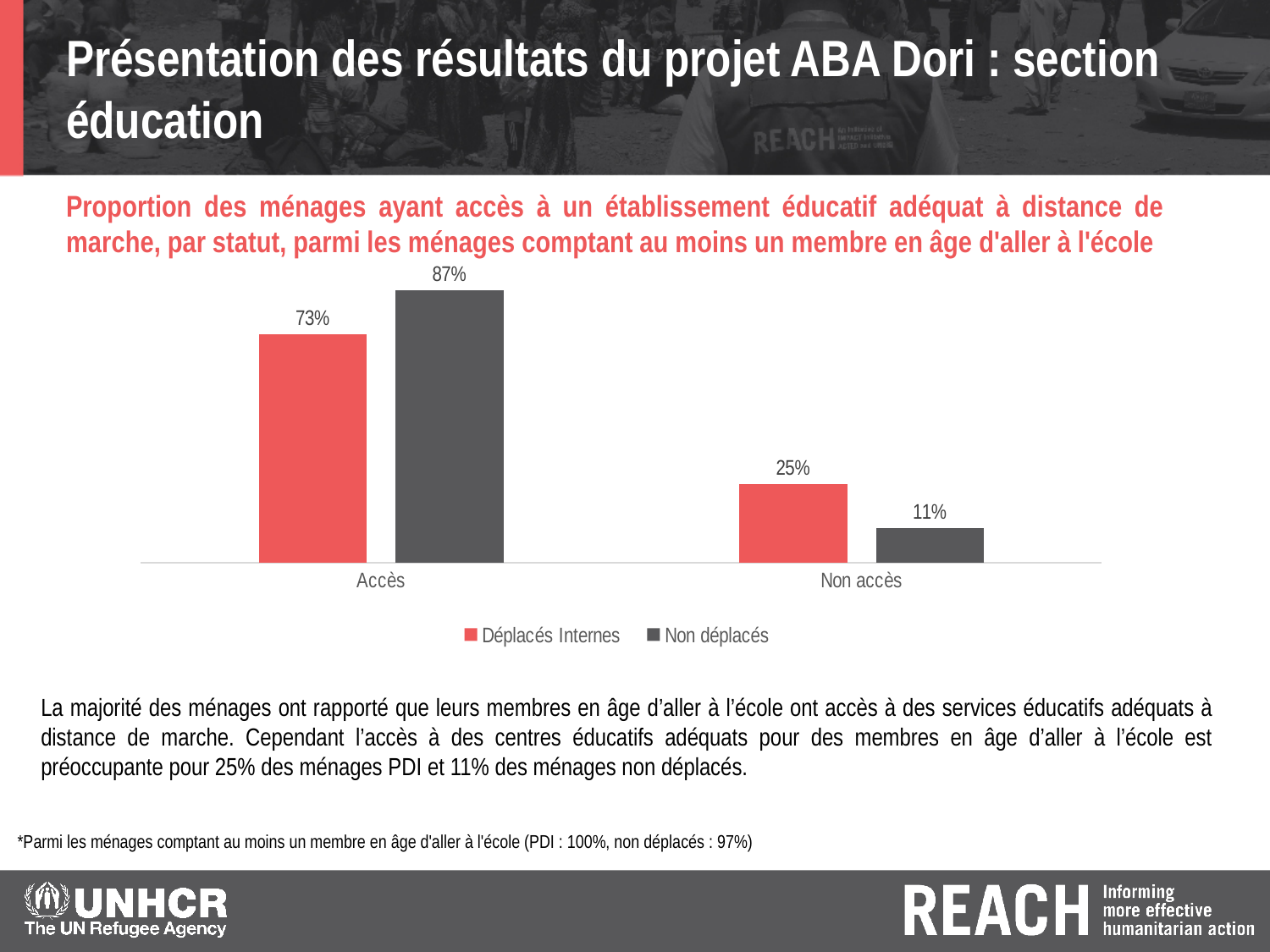
Which bar has the lowest value on the chart? Non déplacés, Non accès (11%) What is the difference between the Déplacés Internes and Non déplacés values in the Non accès category? 14 percentage points What is the value for Non déplacés in the Non accès category? 11% What is the difference between the Non déplacés and Déplacés Internes values in the Accès category? 14 percentage points Which series has the higher value in the Non accès category? Déplacés Internes What is the value for Déplacés Internes in the Non accès category? 25% Which series has the higher value in the Accès category? Non déplacés How many series does the legend list? 2 What is the value for Non déplacés in the Accès category? 87% What kind of chart is shown on the slide? Bar chart How many categories are shown on the x axis? 2 What is the value for Déplacés Internes in the Accès category? 73%